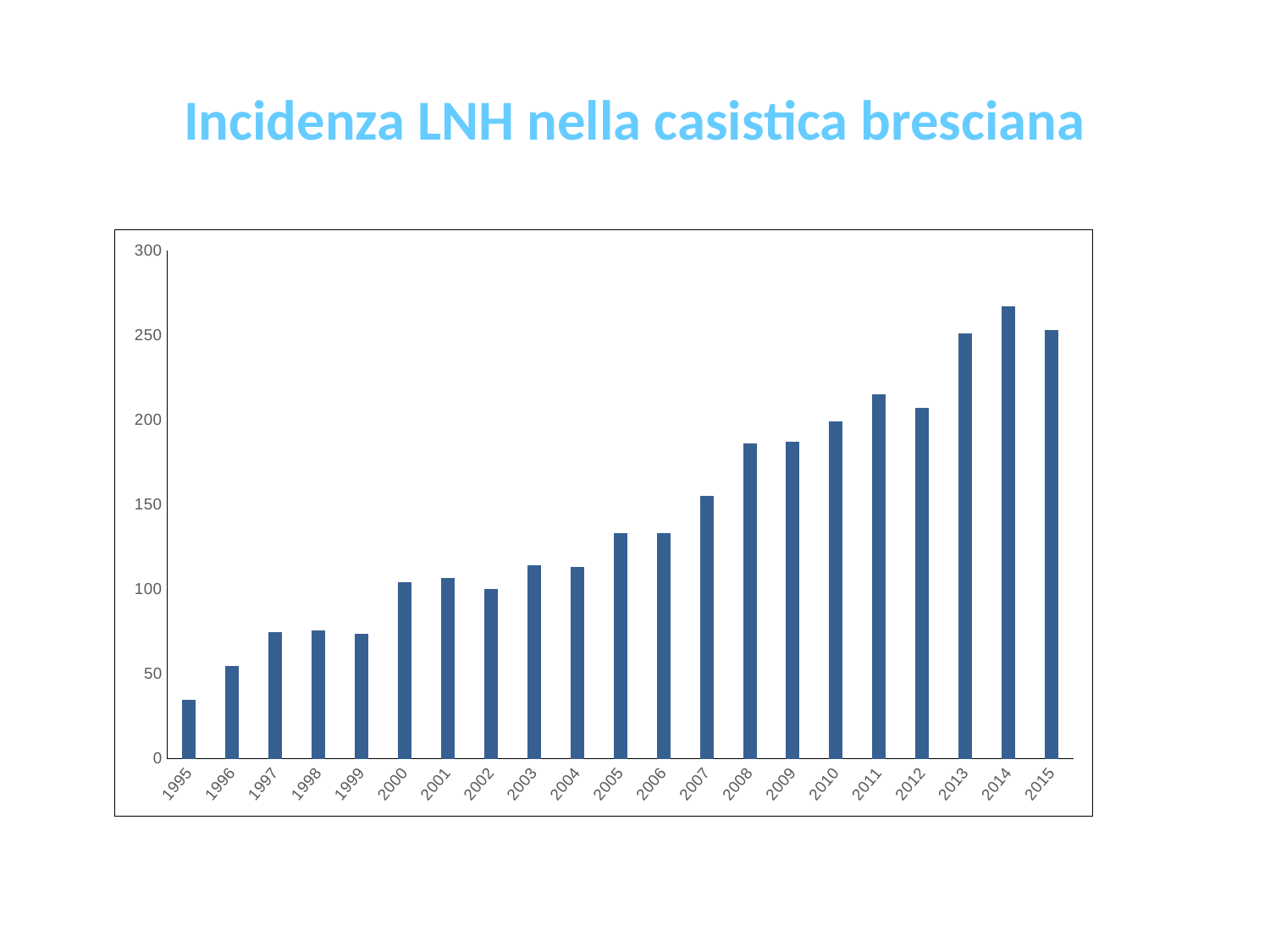
Do the values generally rise or fall from 1995 to 2015? rise Which year has the larger value, 2014 or 2015? 2014 Which year has the larger value, 2011 or 2012? 2011 Which year has the highest bar in the chart? 2014 Which year has the lowest bar in the chart? 1995 Is the value for 2005 greater or less than 150? less What is the title of the chart? Incidenza LNH nella casistica bresciana What type of chart is shown on the slide? bar chart Is the value for 2011 greater or less than 200? greater Is the value for 1995 greater or less than 50? less How many years are shown on the x axis of the chart? 21